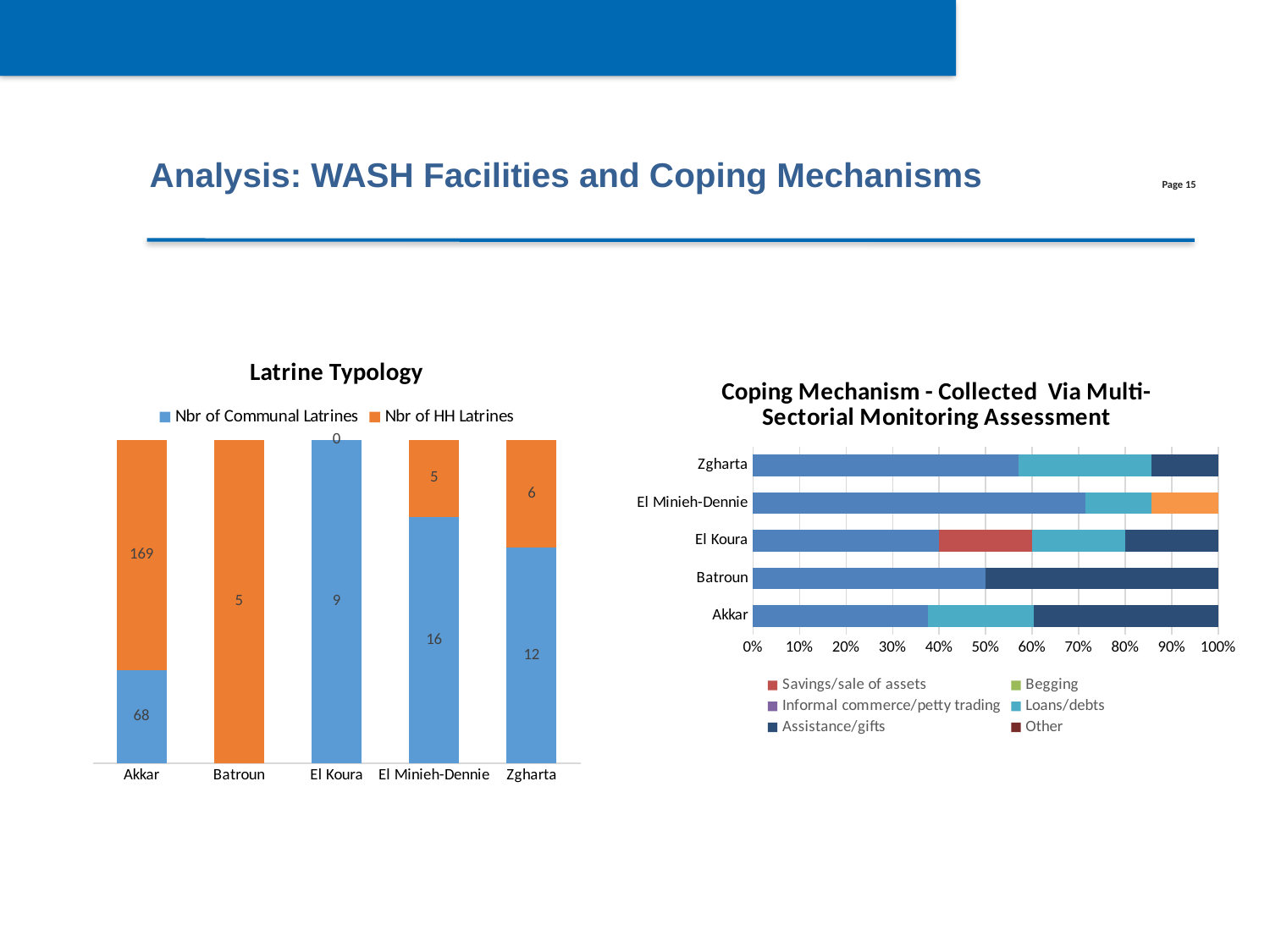
In the Latrine Typology chart, what is the Nbr of Communal Latrines for Akkar? 68 What kind of chart is the Coping Mechanism chart on the right? bar chart How many series does the legend of the Latrine Typology chart list? 2 In the Latrine Typology chart, which has more Communal Latrines, Zgharta or El Minieh-Dennie? El Minieh-Dennie In the Latrine Typology chart, what is the total of the two series for El Minieh-Dennie? 21 In the Latrine Typology chart, what is the difference between the Nbr of HH Latrines and the Nbr of Communal Latrines for Akkar? 101 In the Latrine Typology chart, which category has the highest Nbr of HH Latrines? Akkar In the Coping Mechanism chart, which category's bar includes a red Savings/sale of assets segment? El Koura In the Latrine Typology chart, what is the Nbr of HH Latrines for El Koura? 0 In the Latrine Typology chart, what is the Nbr of HH Latrines for Akkar? 169 How many categories are shown on the vertical axis of the Coping Mechanism chart? 5 In the Latrine Typology chart, what is the Nbr of Communal Latrines for El Minieh-Dennie? 16